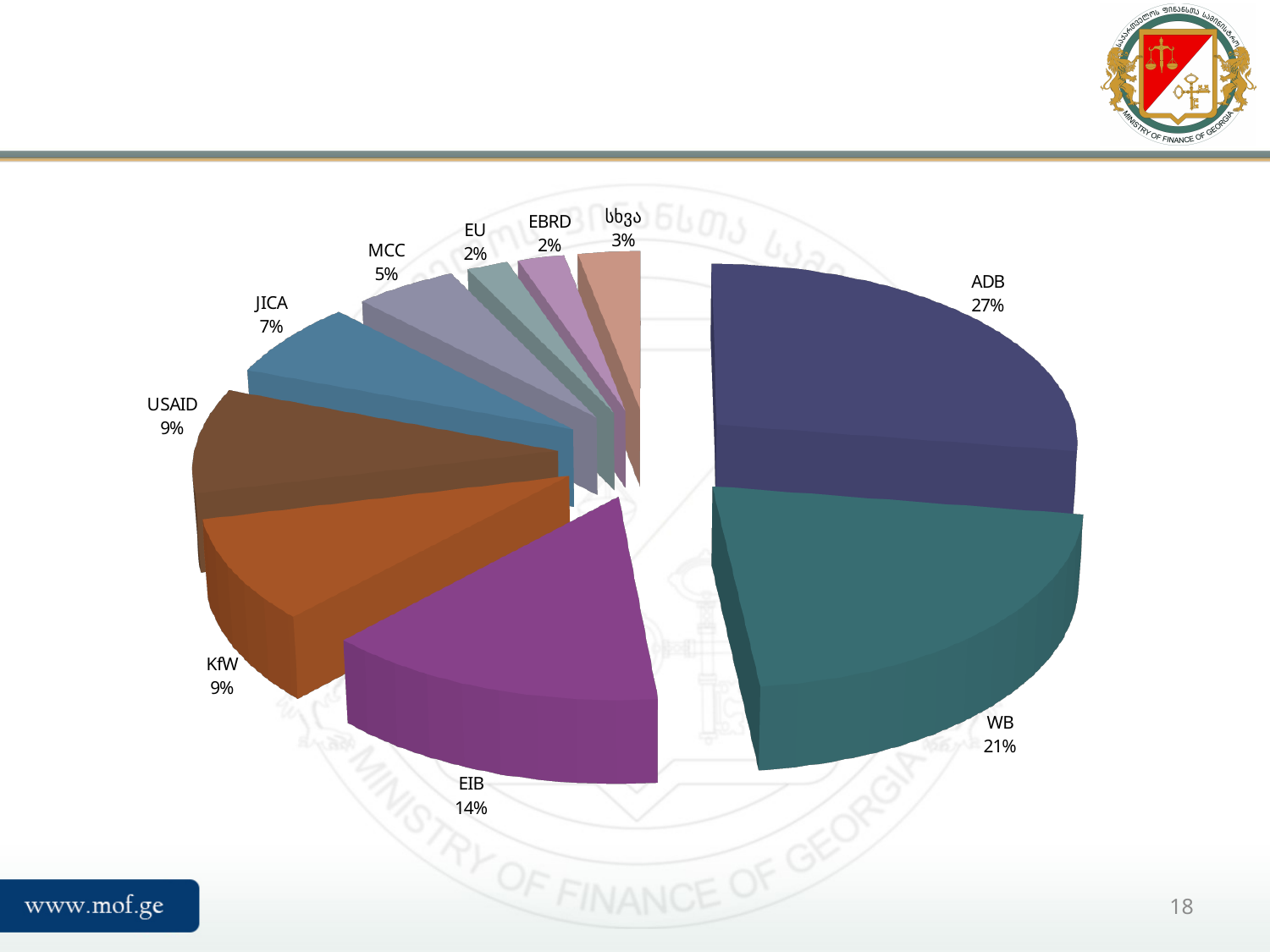
What kind of chart is shown on the slide? pie chart What is the difference between the ADB and WB shares? 6% Which slice of the pie is the largest? ADB What is the value shown for WB? 21% How many slices does the pie chart have? 10 What is the value shown for MCC? 5% What is the value shown for EIB? 14% What is the combined share of EU and EBRD? 4% What share of the pie does ADB hold? 27% Which is larger, the share for EIB or the share for KfW? EIB What is the value shown for JICA? 7% What is the difference between the USAID and JICA shares? 2%